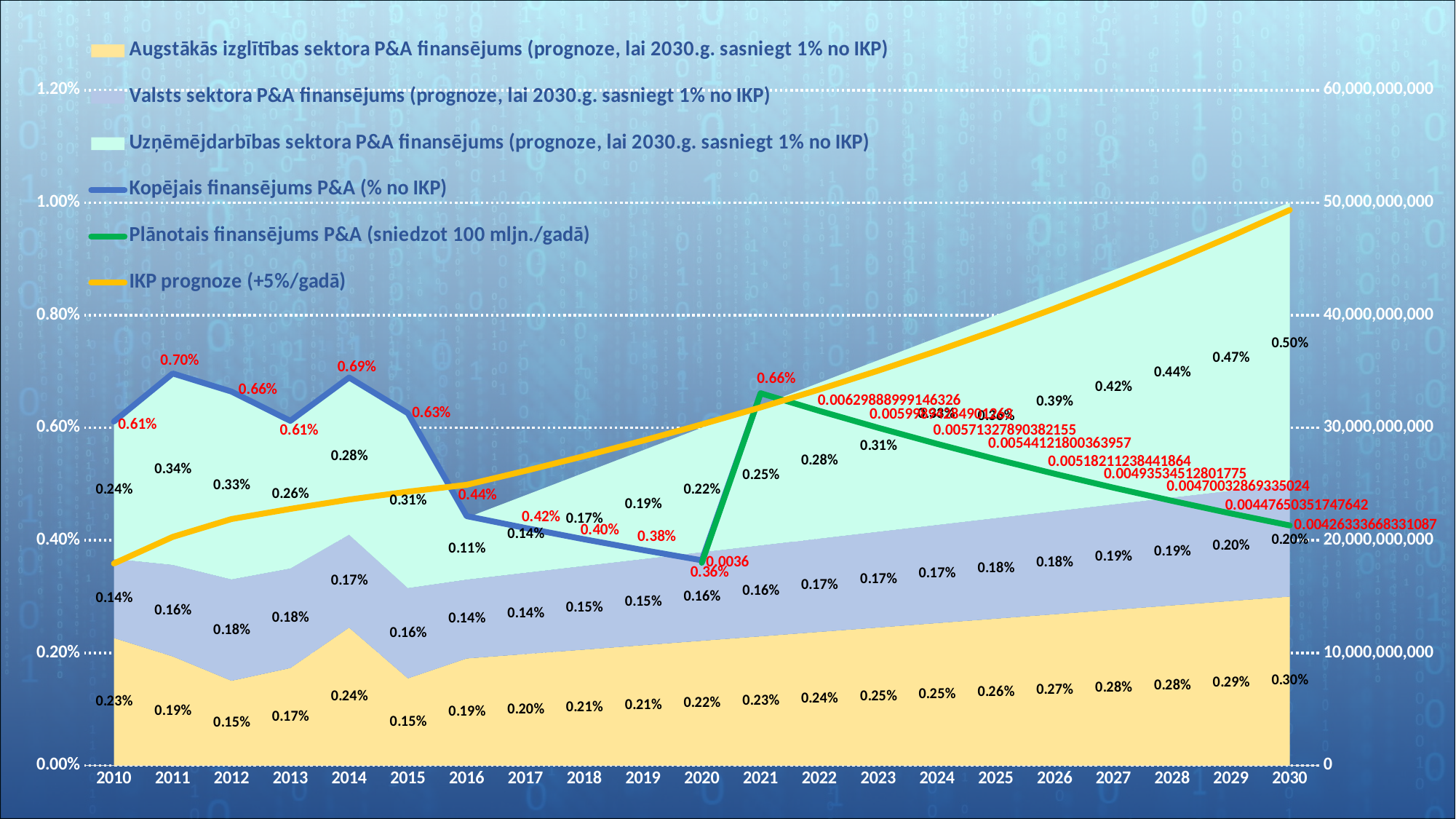
In which year is Uzņēmējdarbības sektora P&A finansējums at its lowest labelled value? 2016 What is the value of Augstākās izglītības sektora P&A finansējums in 2030? 0.30% Is the IKP prognoze (+5%/gadā) value in 2030 greater or less than 40,000,000,000 on the right axis? greater What colour is the line for Plānotais finansējums P&A (sniedzot 100 mljn./gadā)? green Does the IKP prognoze (+5%/gadā) line rise or fall from 2010 to 2030? rise What is the value of Valsts sektora P&A finansējums in 2010? 0.14% How many series does the legend list? 6 How many years are shown along the x axis? 21 What is the difference between Kopējais finansējums P&A (% no IKP) in 2011 and in 2020? 0.34% Which year has the larger value for Augstākās izglītības sektora P&A finansējums, 2014 or 2015? 2014 What is the value of Kopējais finansējums P&A (% no IKP) in 2011? 0.70% In which year does Kopējais finansējums P&A (% no IKP) reach its highest labelled value? 2011